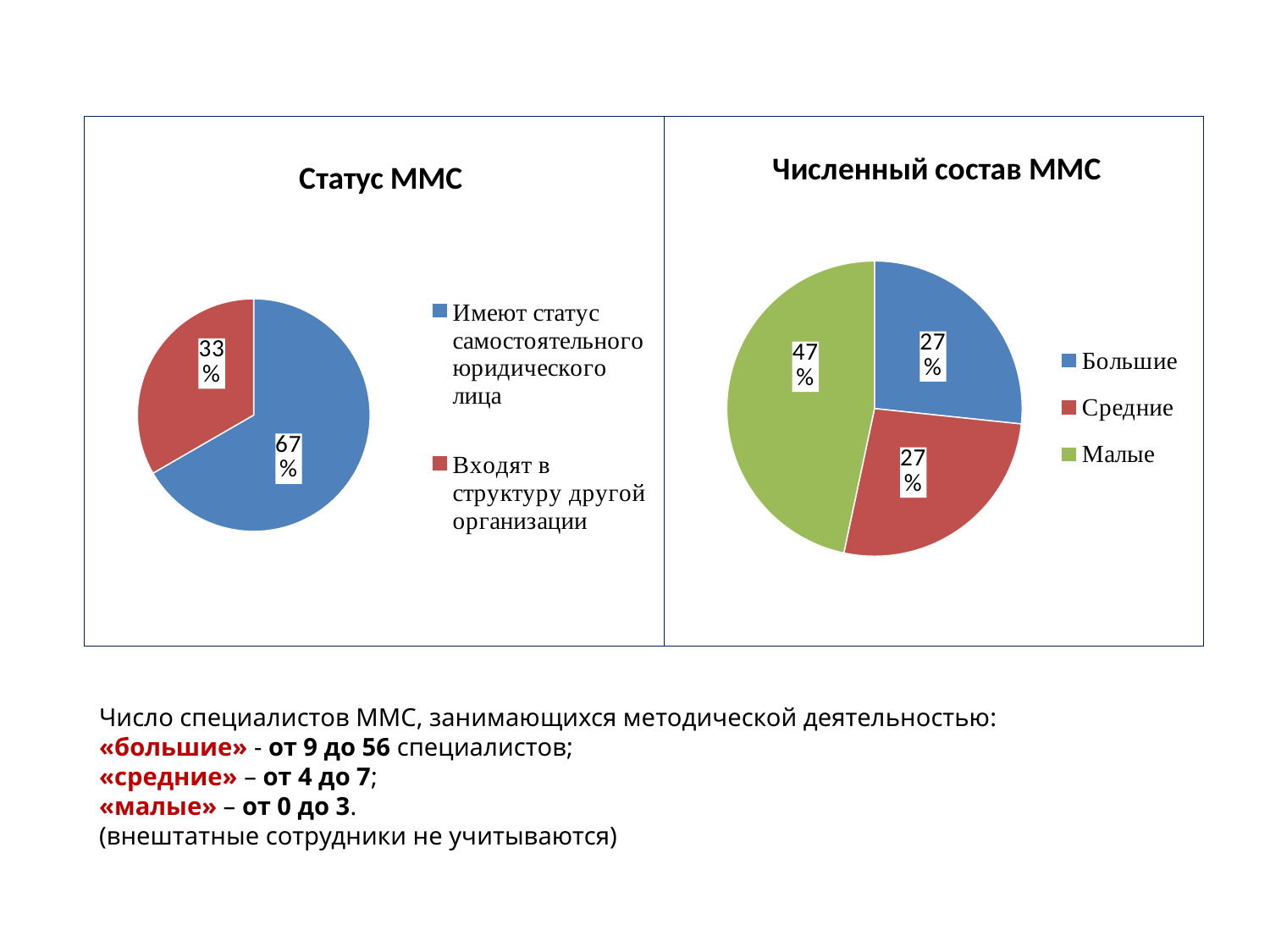
What kind of chart is the one titled "Численный состав ММС"? pie chart In the chart titled "Статус ММС", what is the difference in percentage points between the two slices? 34 In the chart titled "Численный состав ММС", what share of the pie is "Большие"? 27% In the chart titled "Численный состав ММС", what share of the pie is "Малые"? 47% In the chart titled "Статус ММС", what share of the pie is "Имеют статус самостоятельного юридического лица"? 67% In the chart titled "Численный состав ММС", what colour is the "Малые" slice? green In the chart titled "Численный состав ММС", how many categories are shown? 3 In the chart titled "Численный состав ММС", which category has the largest slice? Малые In the chart titled "Статус ММС", how many categories does the legend list? 2 In the chart titled "Численный состав ММС", what is the difference in percentage points between "Малые" and "Средние"? 20 In the chart titled "Статус ММС", which category has the largest slice? Имеют статус самостоятельного юридического лица